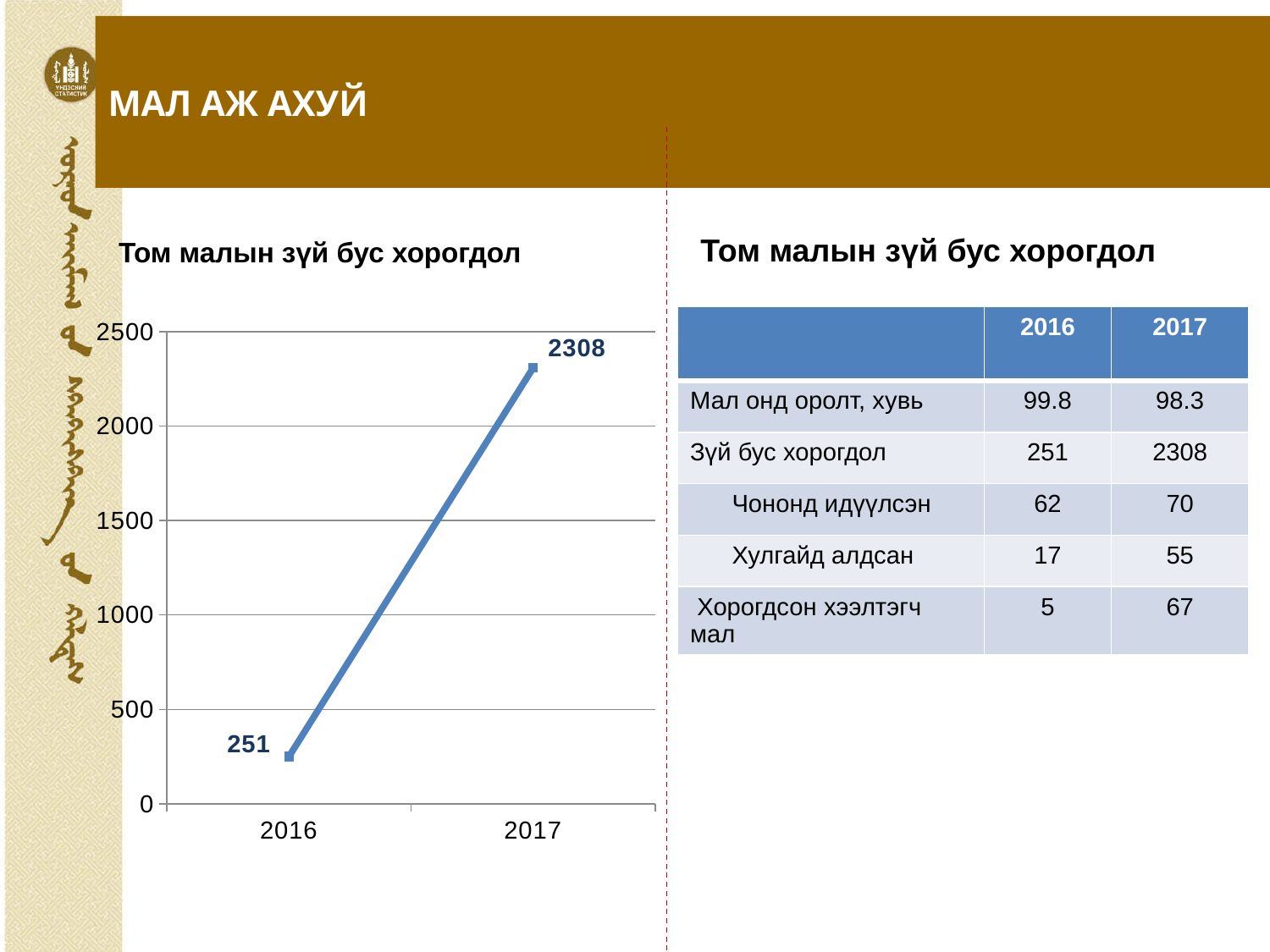
Which year has the higher value in the chart? 2017 Is the value for 2017 greater or less than 2000? greater What is the maximum value shown on the chart's vertical axis? 2500 What is the difference between the 2017 and 2016 values in the chart? 2057 Do the values rise or fall from 2016 to 2017? rise How many data points are plotted in the chart? 2 Is the value for 2016 greater or less than 500? less Which year has the lower value in the chart? 2016 What is the title of the chart? Том малын зүй бус хорогдол What is the value for 2017 in the chart? 2308 What kind of chart is shown on the slide? line chart What is the value for 2016 in the chart? 251